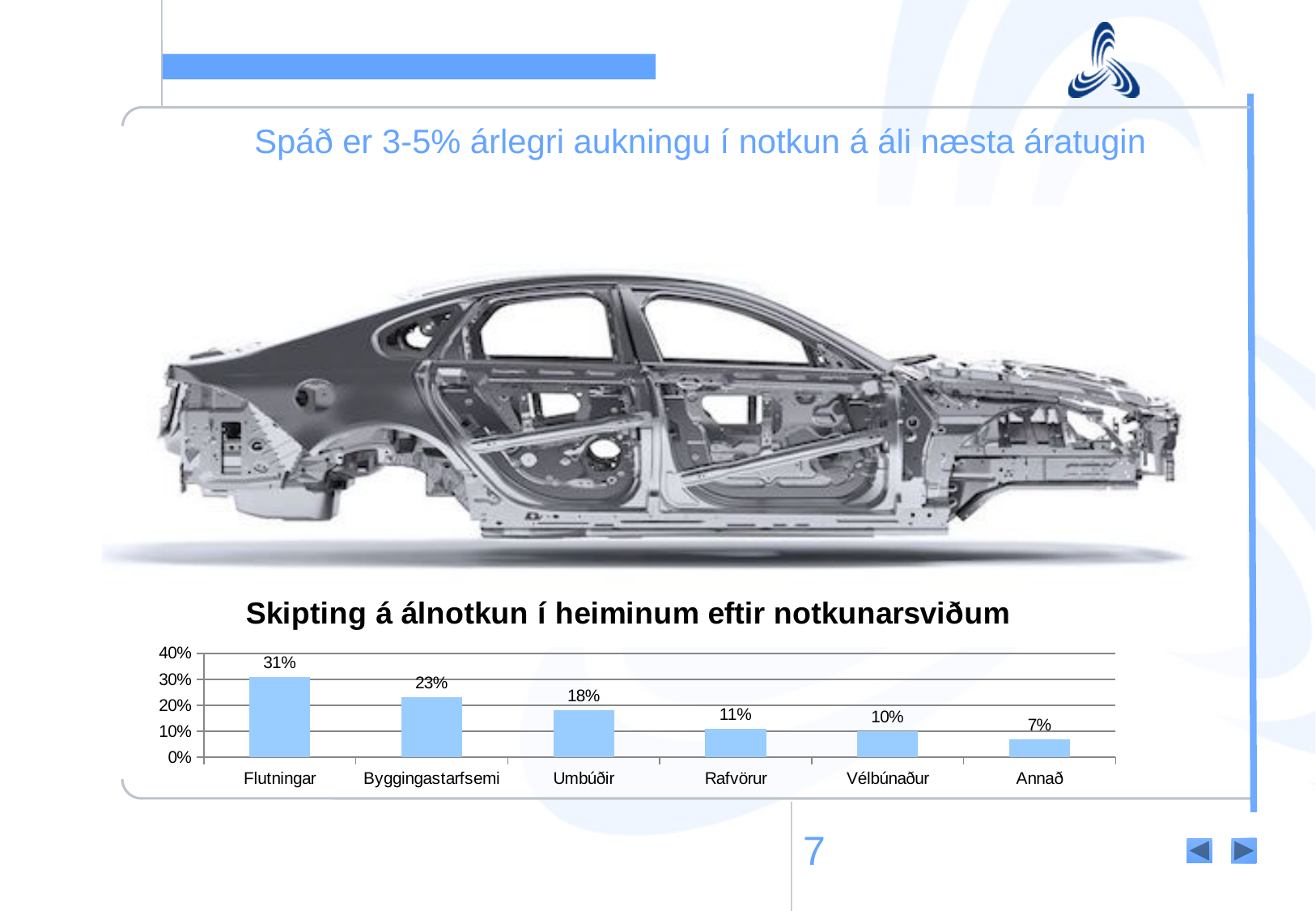
What is the value for Rafvörur? 11% Which category has the lowest value? Annað What is the value for Byggingastarfsemi? 23% What kind of chart is shown on the slide? bar chart Which category has the highest value? Flutningar What is the title of the chart? Skipting á álnotkun í heiminum eftir notkunarsviðum Which is larger, the value for Umbúðir or the value for Vélbúnaður? Umbúðir What is the value for Flutningar? 31% What is the difference between the values for Flutningar and Umbúðir? 13% Is the value for Byggingastarfsemi greater or less than 20%? greater What is the difference between the values for Byggingastarfsemi and Annað? 16% How many categories are shown on the x axis? 6